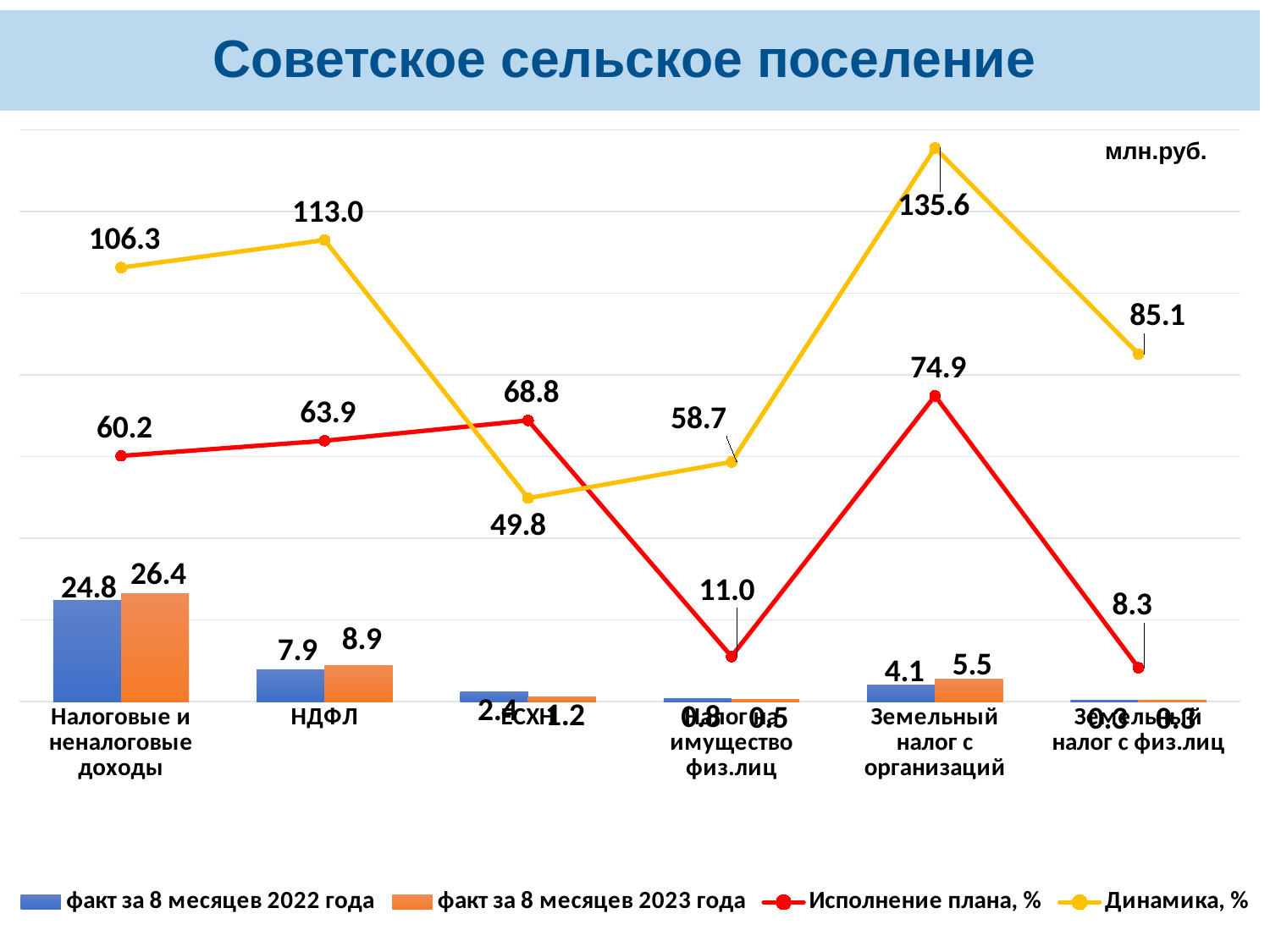
What is the value of 'Исполнение плана, %' for Земельный налог с организаций? 74.9 What is the value of 'Динамика, %' for ЕСХН? 49.8 How many series does the legend list? 4 What is the difference between 'факт за 8 месяцев 2023 года' and 'факт за 8 месяцев 2022 года' for Налоговые и неналоговые доходы? 1.6 How many categories are shown on the x axis? 6 What kind of chart is shown on the slide? Combination bar and line chart Which category has the highest value of 'факт за 8 месяцев 2022 года'? Налоговые и неналоговые доходы Which category has the highest value of 'Динамика, %'? Земельный налог с организаций For ЕСХН, which is larger: 'факт за 8 месяцев 2022 года' or 'факт за 8 месяцев 2023 года'? факт за 8 месяцев 2022 года Which category has the lowest value of 'Исполнение плана, %'? Земельный налог с физ.лиц What is the difference between 'Динамика, %' for НДФЛ and for Налоговые и неналоговые доходы? 6.7 What is the value of 'факт за 8 месяцев 2023 года' for НДФЛ? 8.9